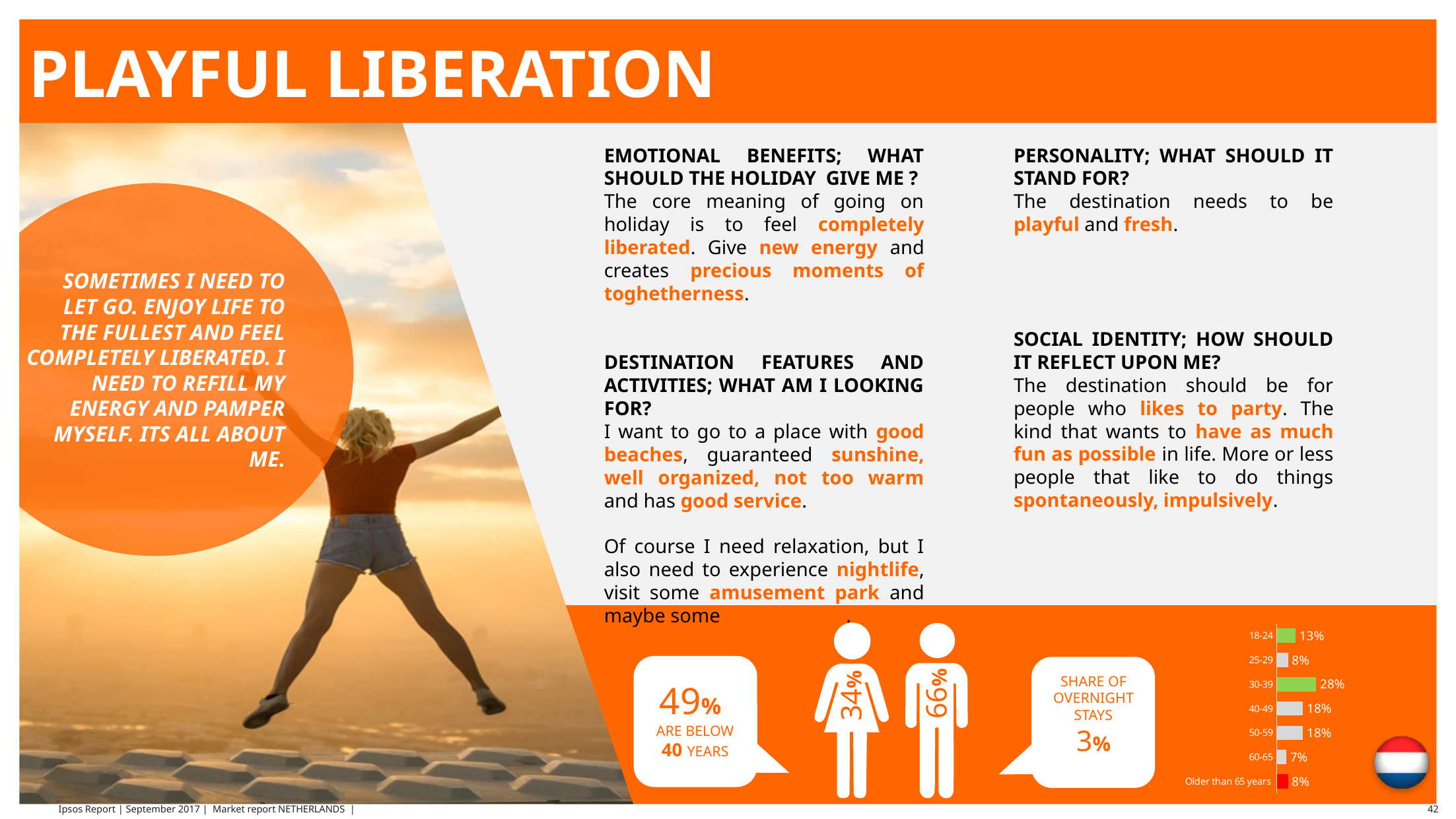
How many age groups are shown in the age-group bar chart? 7 In the age-group bar chart, which is larger, the value for 18-24 or the value for 60-65? 18-24 In the age-group bar chart, what is the difference between the values for 18-24 and 25-29? 5% In the age-group bar chart, which age group has the highest value? 30-39 What kind of chart is the age-group chart on the slide? Bar chart In the age-group bar chart, what is the value for the 60-65 age group? 7% In the age-group bar chart, which age group has the lowest value? 60-65 In the age-group bar chart, what colour is the bar for the 30-39 age group? Green In the age-group bar chart, what is the difference between the values for 30-39 and 40-49? 10% In the age-group bar chart, what is the value for people older than 65 years? 8% In the age-group bar chart, what is the value for the 30-39 age group? 28% In the age-group bar chart, what is the value for the 18-24 age group? 13%